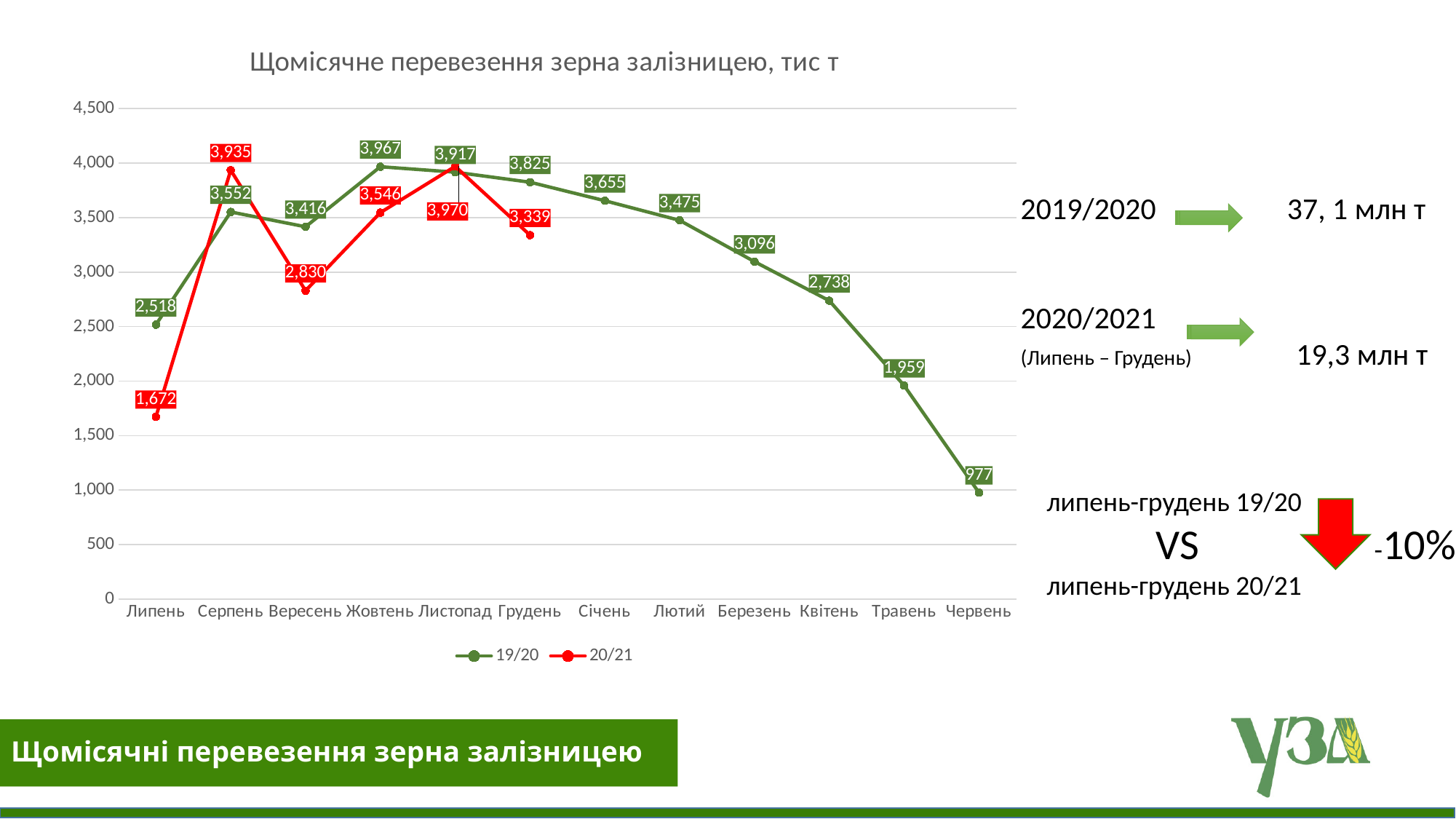
How many series does the legend list? 2 How many months are shown on the x axis? 12 What is the title of the chart? Щомісячне перевезення зерна залізницею, тис т Does the 19/20 series rise or fall from Грудень to Червень? fall What is the value for the 20/21 series in Липень? 1,672 In which month is the 19/20 series at its lowest? Червень What is the value for the 19/20 series in Жовтень? 3,967 What is the difference between the 19/20 and 20/21 values in Липень? 846 Which series has the larger value in Серпень, 19/20 or 20/21? 20/21 In which month is the 20/21 series at its highest? Листопад What type of chart is shown on the slide? line chart What is the value for the 19/20 series in Червень? 977